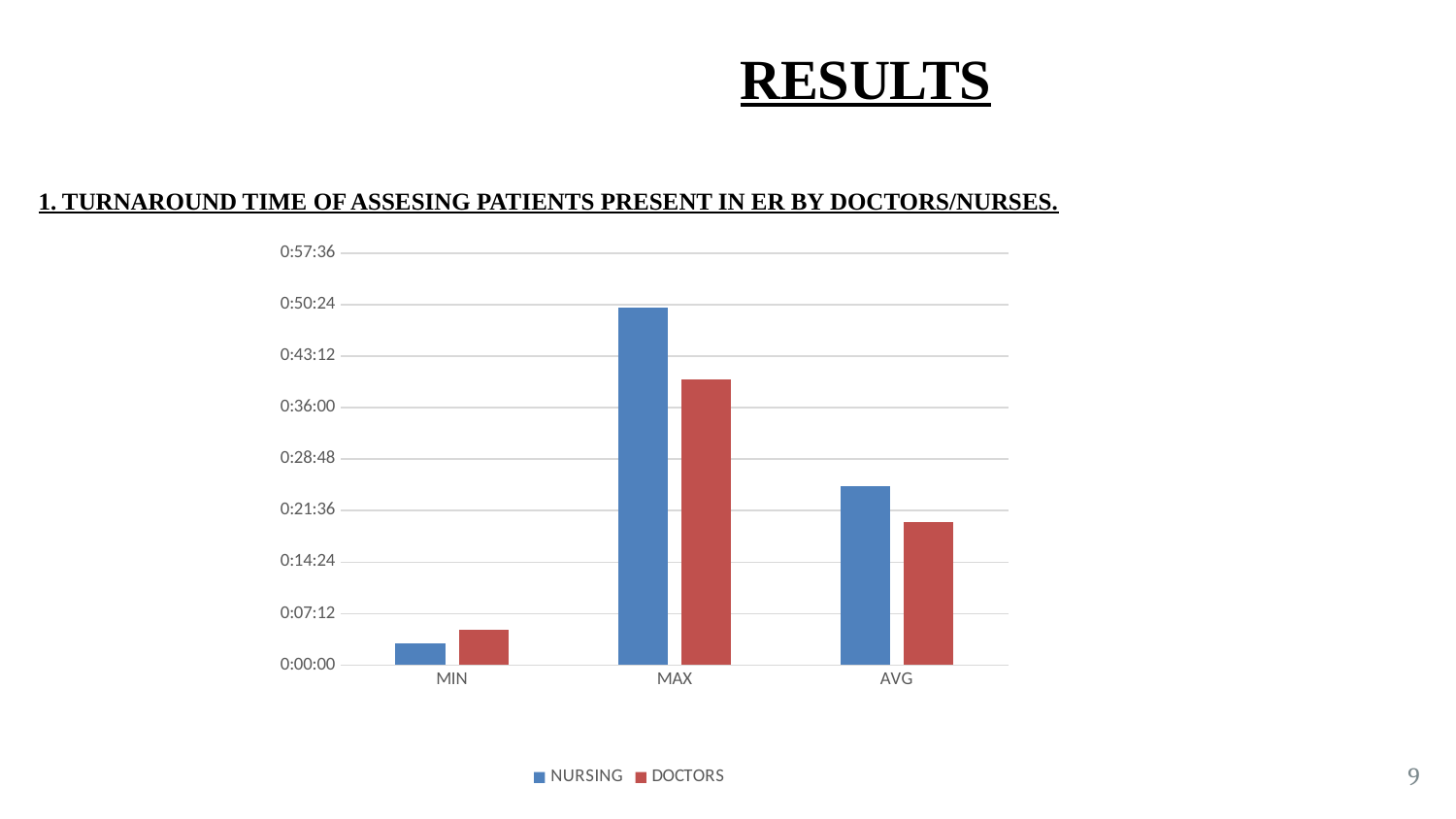
Is the DOCTORS value for AVG greater or less than 0:21:36? less Which series are listed in the chart's legend? NURSING and DOCTORS Which category has the tallest bar in the chart? MAX Is the NURSING value for MIN greater or less than 0:07:12? less Is the NURSING value for MAX greater or less than 0:43:12? greater Which category has the shortest bars in the chart? MIN For the AVG category, which series has the larger value, NURSING or DOCTORS? NURSING How many series does the chart's legend list? 2 For the MAX category, which series has the larger value, NURSING or DOCTORS? NURSING For the MIN category, which series has the larger value, NURSING or DOCTORS? DOCTORS What kind of chart is shown on the slide? bar chart How many categories are shown on the x axis of the chart? 3